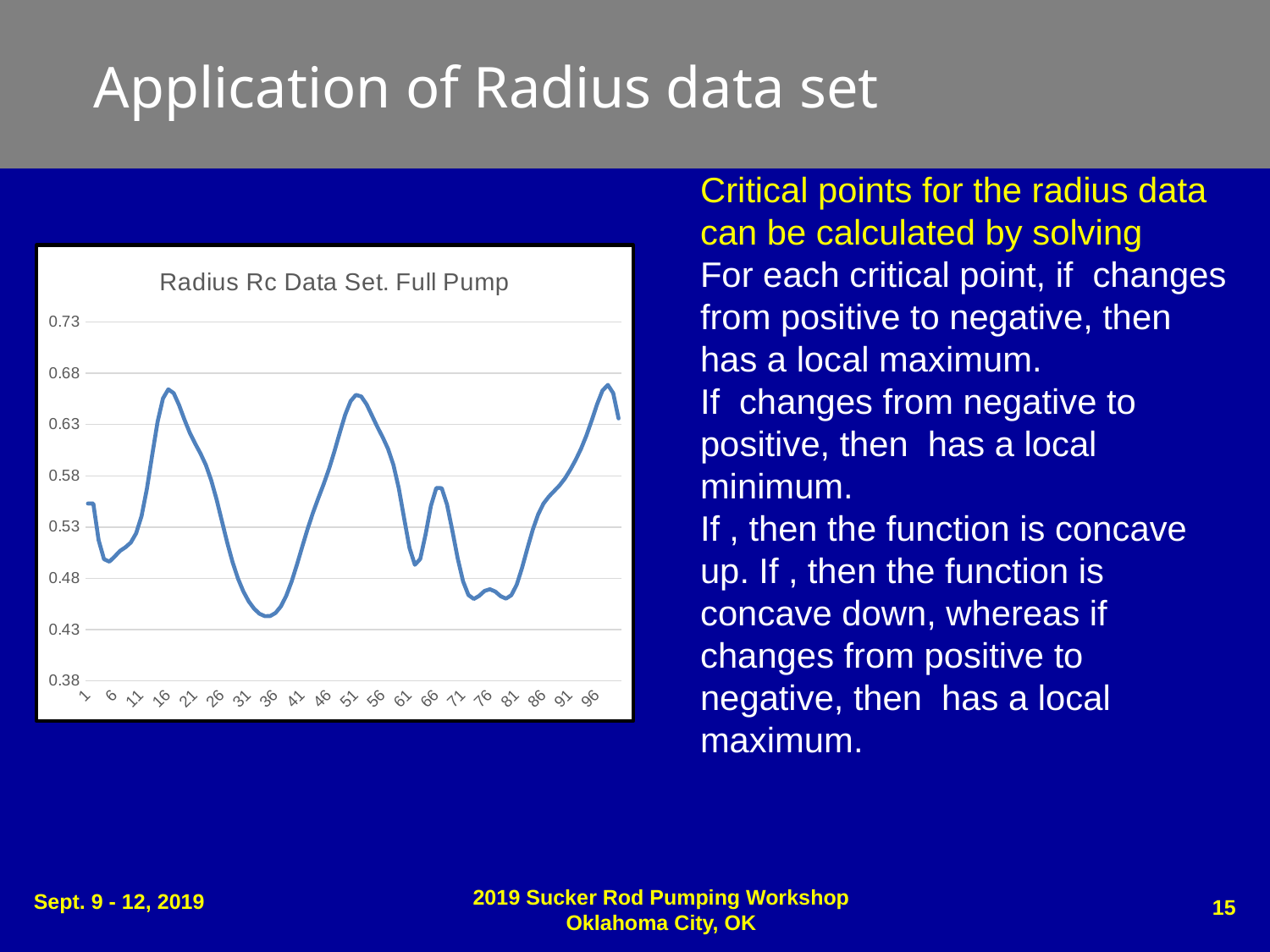
Which is larger, the value at x = 61 or the value at x = 66? x = 66 How many tick labels are shown on the x axis of the chart? 20 Is the value at x = 51 greater or less than 0.63? greater Is the value at x = 61 greater or less than 0.53? less Which is larger, the value at x = 16 or the value at x = 36? x = 16 What is the title of the chart? Radius Rc Data Set. Full Pump Is the value at x = 16 greater or less than 0.63? greater Between x = 16 and x = 36, do the values rise or fall? fall What kind of chart is shown on the slide? line chart What is the highest value labelled on the y axis of the chart? 0.73